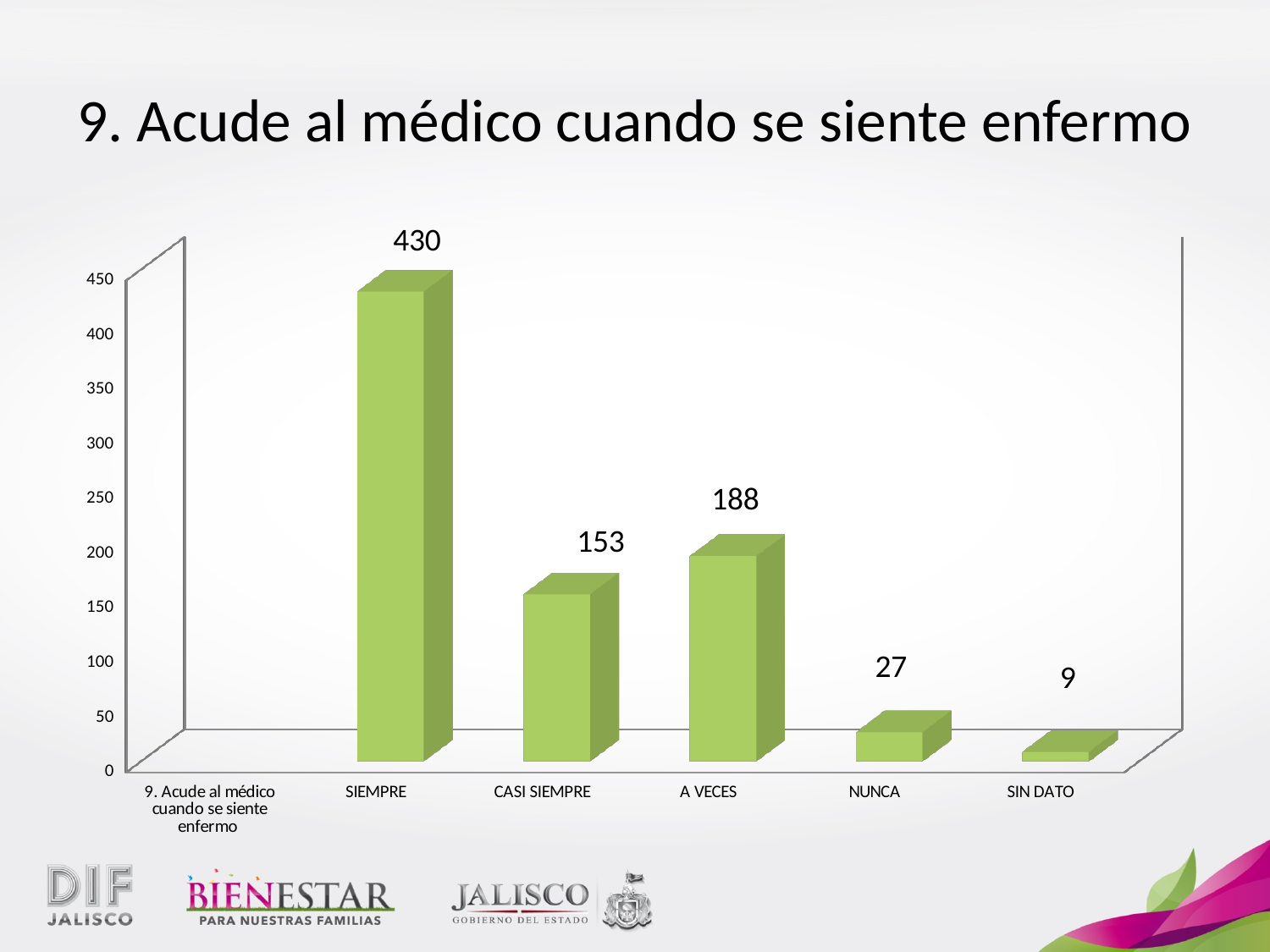
What kind of chart is shown on the slide? bar chart What is the value for SIN DATO? 9 Which category has the lowest value? SIN DATO Is the value for NUNCA greater or less than 50? less What is the value for NUNCA? 27 What is the title of the slide? 9. Acude al médico cuando se siente enfermo What is the value for SIEMPRE? 430 Which category has the highest value? SIEMPRE Which is larger, the value for CASI SIEMPRE or the value for A VECES? A VECES What is the value for A VECES? 188 What is the value for CASI SIEMPRE? 153 What is the difference between the values for SIEMPRE and A VECES? 242